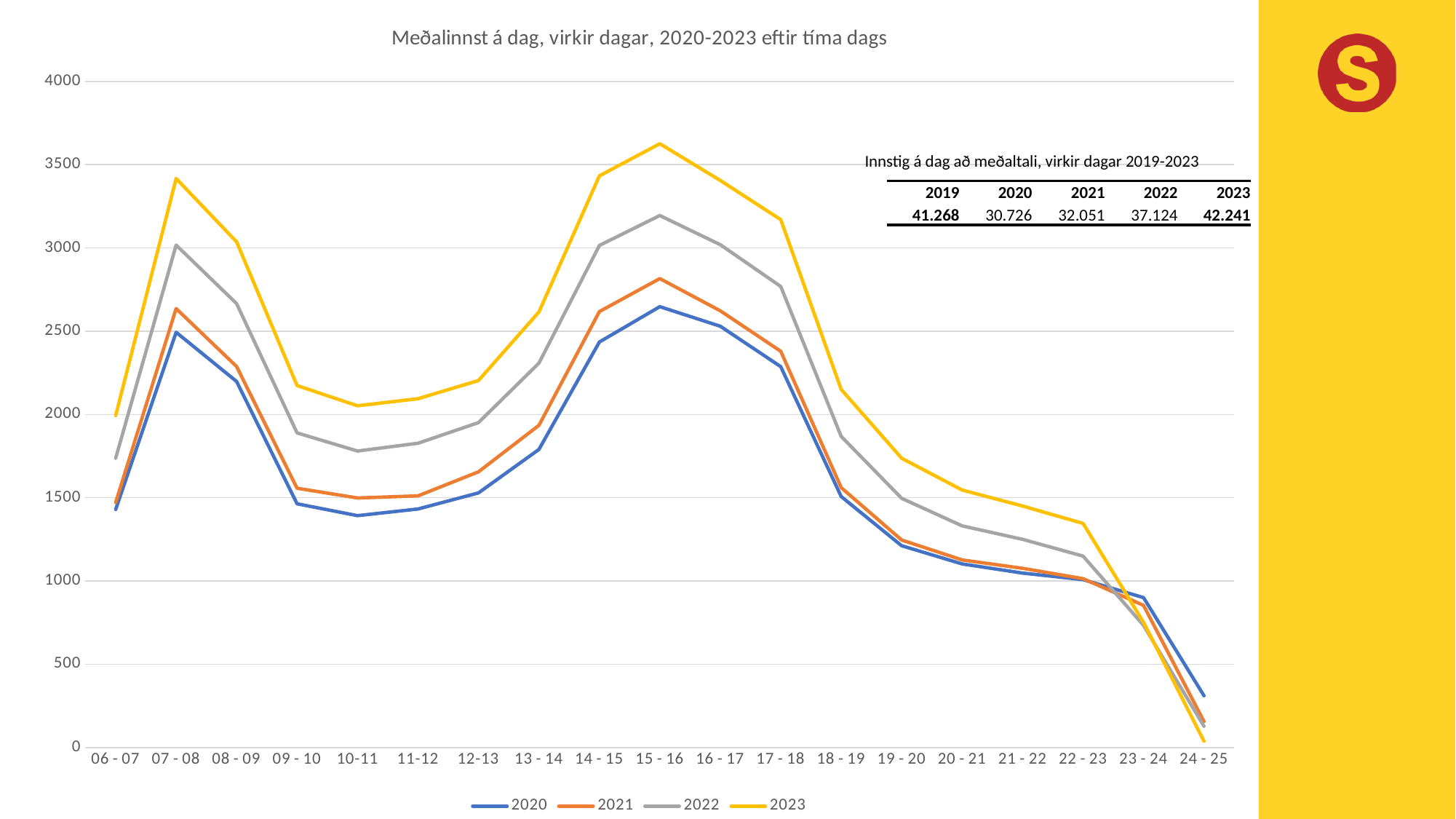
Which time slot has the highest value for the 2023 series? 15 - 16 At 07 - 08, which is larger: the value for 2023 or the value for 2020? 2023 What kind of chart is shown on the slide? line chart Is the value for 2022 at 15 - 16 greater or less than 3000? greater What is the title of the chart? Meðalinnst á dag, virkir dagar, 2020-2023 eftir tíma dags Is the value for 2023 at 15 - 16 greater or less than 3500? greater Which series has the highest value at 15 - 16? 2023 Which series has the lowest value at 15 - 16? 2020 How many series does the chart legend list? 4 Does the 2023 series rise or fall from 15 - 16 to 24 - 25? fall How many time-of-day categories are shown on the x axis of the chart? 19 Is the value for 2020 at 10-11 greater or less than 1500? less